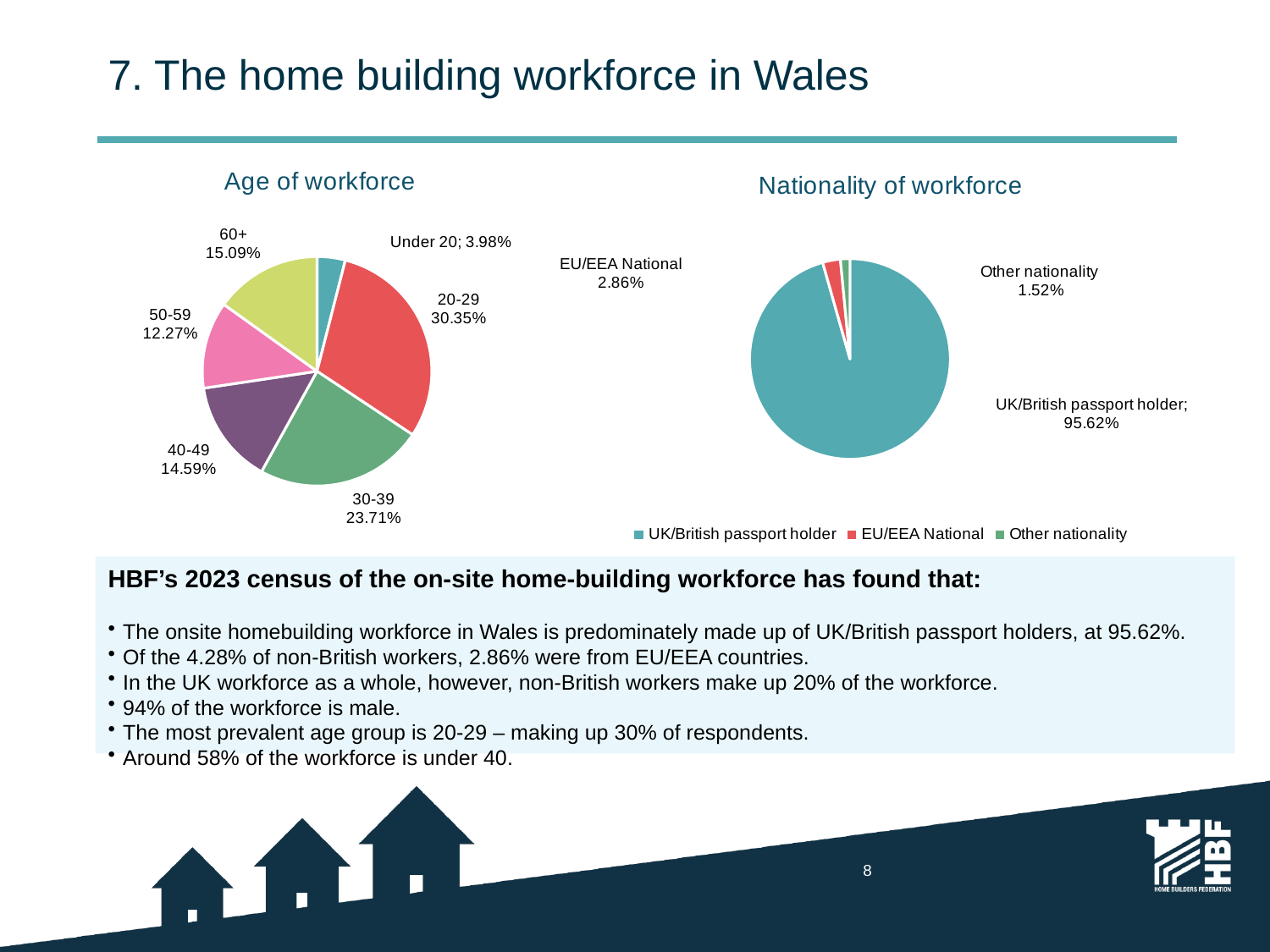
In the 'Age of workforce' chart, what share of the workforce is aged 60+? 15.09% In the 'Nationality of workforce' chart, what share of the workforce are UK/British passport holders? 95.62% What kind of chart is the 'Nationality of workforce' chart? Pie chart In the 'Age of workforce' chart, what share of the workforce is aged 20-29? 30.35% In the 'Nationality of workforce' chart, what share of the workforce are EU/EEA Nationals? 2.86% In the 'Nationality of workforce' chart, what is the difference between the EU/EEA National share and the Other nationality share? 1.34% How many age groups are shown in the 'Age of workforce' chart? 6 In the 'Age of workforce' chart, which age group has the smallest share? Under 20 In the 'Age of workforce' chart, which age group has the largest share? 20-29 In the 'Age of workforce' chart, what is the difference between the 30-39 share and the 40-49 share? 9.12% In the 'Age of workforce' chart, which is larger: the 50-59 share or the 60+ share? 60+ How many entries does the legend of the 'Nationality of workforce' chart list? 3